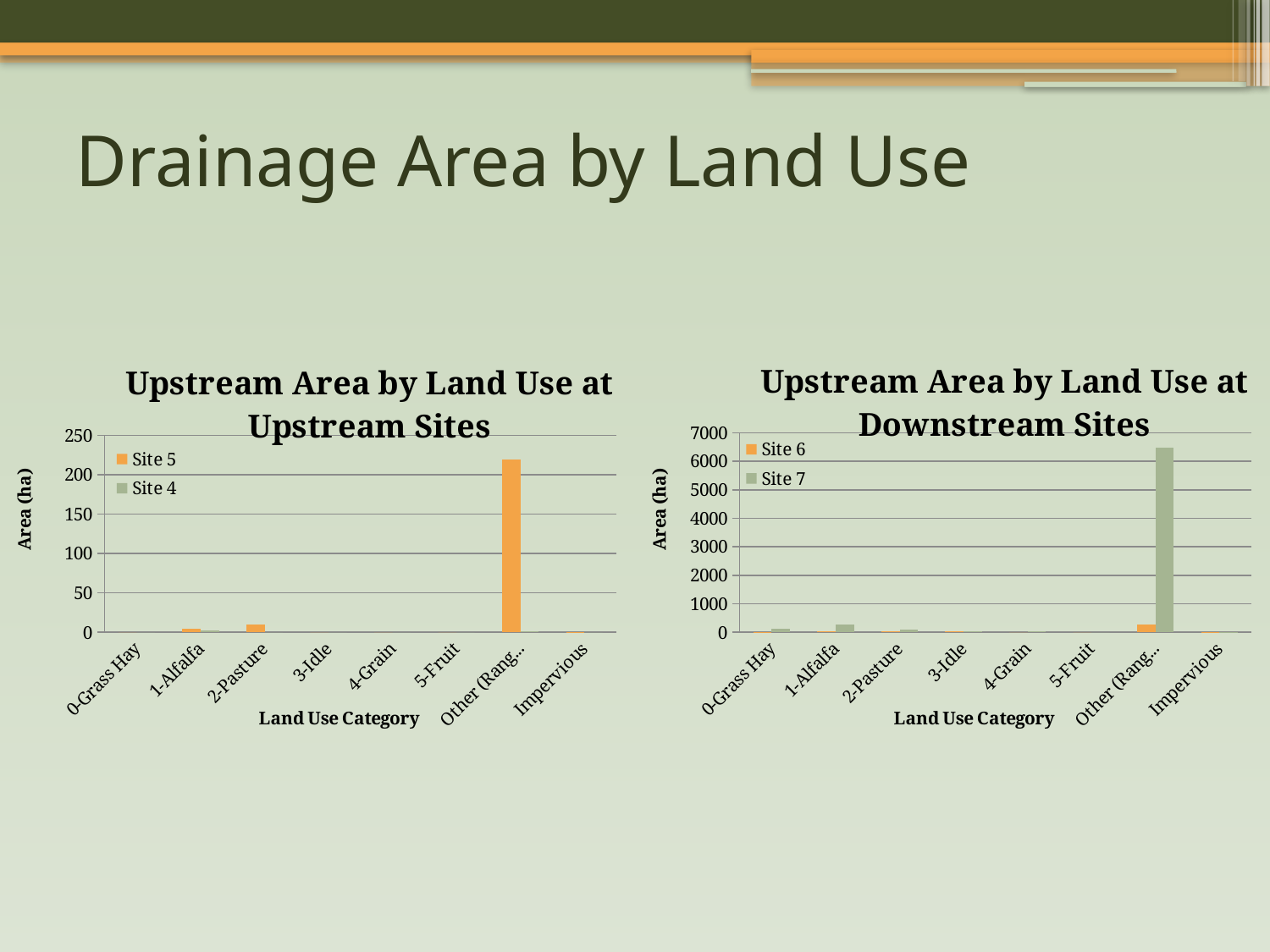
In the right chart, 'Upstream Area by Land Use at Downstream Sites', is the Site 7 value for 1-Alfalfa greater or less than 1000? less Which series does the legend of the right chart, 'Upstream Area by Land Use at Downstream Sites', list? Site 6 and Site 7 How many series does the legend of the left chart, 'Upstream Area by Land Use at Upstream Sites', list? 2 What is the y-axis label of the left chart, 'Upstream Area by Land Use at Upstream Sites'? Area (ha) In the right chart, 'Upstream Area by Land Use at Downstream Sites', which land use category has the highest value for Site 7? Other (Rang... In the left chart, 'Upstream Area by Land Use at Upstream Sites', which land use category has the highest value for Site 5? Other (Rang... In the right chart, 'Upstream Area by Land Use at Downstream Sites', which is larger for Other (Rang...: Site 6 or Site 7? Site 7 In the left chart, 'Upstream Area by Land Use at Upstream Sites', which is larger for Other (Rang...: Site 5 or Site 4? Site 5 In the right chart, 'Upstream Area by Land Use at Downstream Sites', is the Site 7 value for Other (Rang... greater or less than 6000? greater What kind of chart is the left chart, 'Upstream Area by Land Use at Upstream Sites'? bar chart How many land use categories are shown on the x axis of the right chart, 'Upstream Area by Land Use at Downstream Sites'? 8 In the left chart, 'Upstream Area by Land Use at Upstream Sites', is the Site 5 value for Other (Rang... greater or less than 200? greater